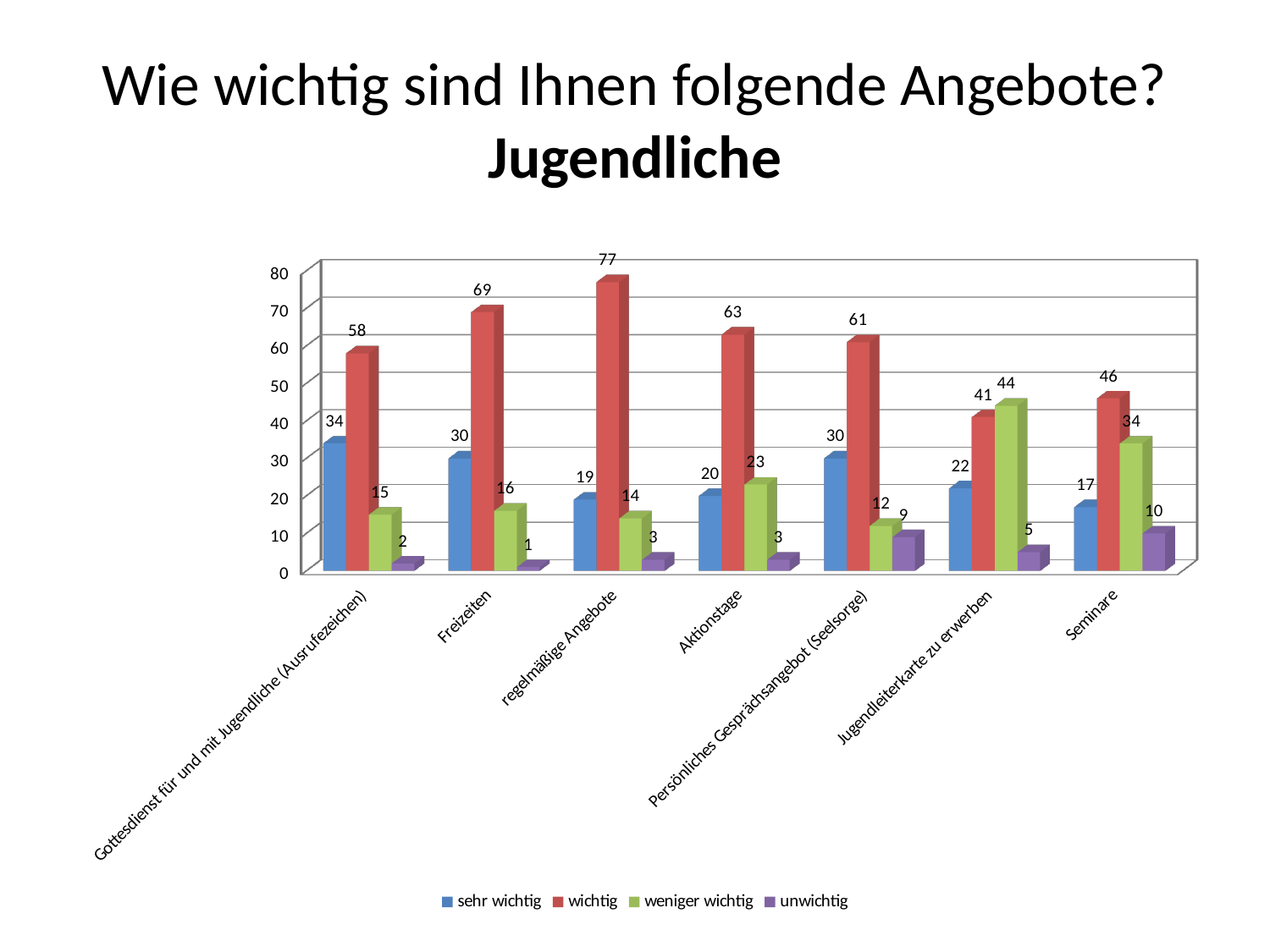
What is the value for "weniger wichtig" for Jugendleiterkarte zu erwerben? 44 Which is larger for Jugendleiterkarte zu erwerben: "wichtig" or "weniger wichtig"? weniger wichtig Which category has the lowest value for "unwichtig"? Freizeiten What kind of chart is shown on the slide? Bar chart Which category has the highest value for "wichtig"? regelmäßige Angebote What is the value for "unwichtig" for Seminare? 10 What is the value for "wichtig" for regelmäßige Angebote? 77 What is the value for "sehr wichtig" for Freizeiten? 30 How many categories are shown on the x axis? 7 What is the difference between the "wichtig" and "sehr wichtig" values for Aktionstage? 43 Which colour represents the "unwichtig" series? Purple How many series does the legend list? 4